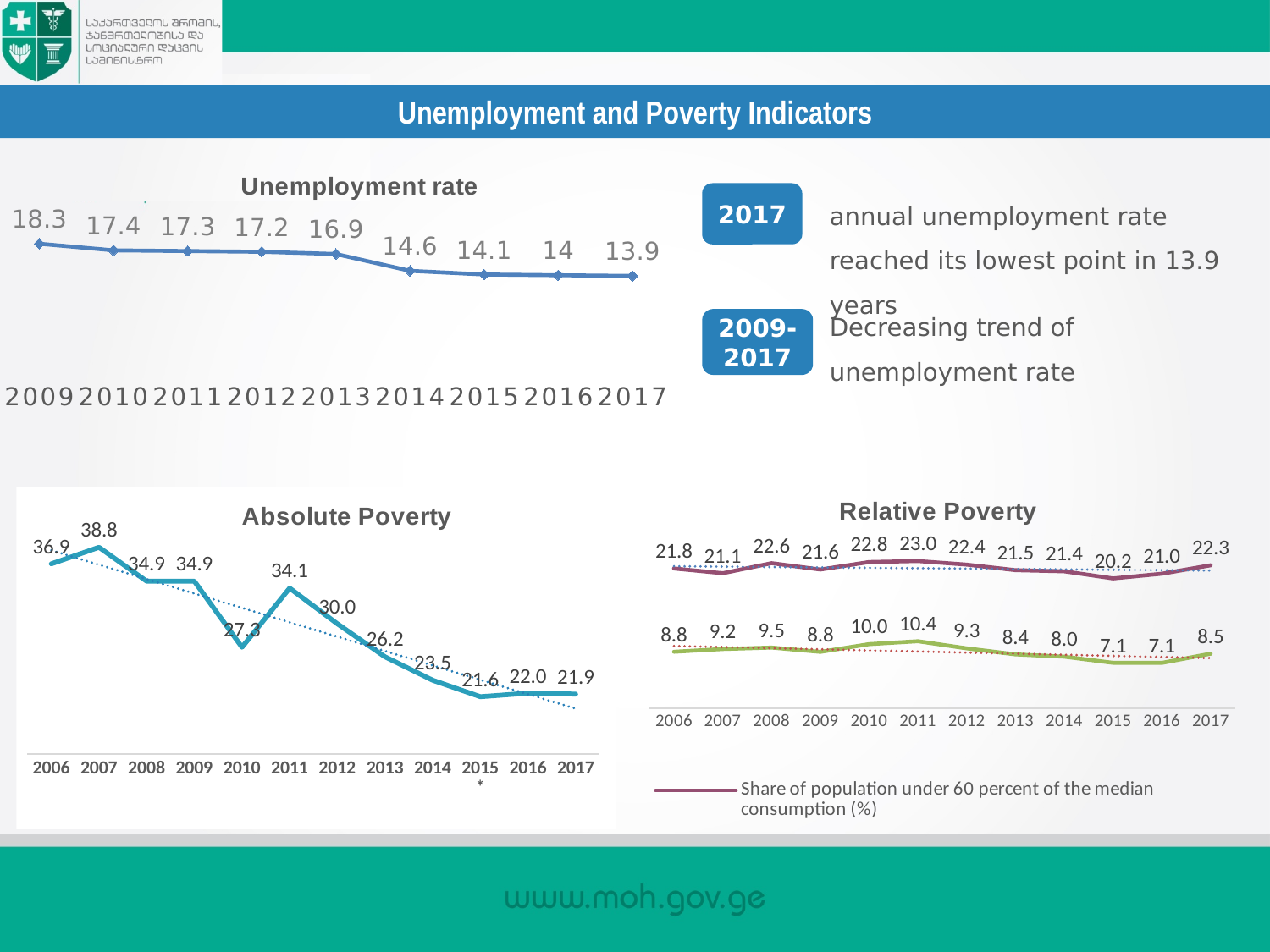
In the Unemployment rate chart, do the values rise or fall from 2009 to 2017? fall In the Unemployment rate chart, what is the difference between the 2009 and 2017 values? 4.4 In the Absolute Poverty chart, which year has the lowest value? 2015 What kind of chart is the Absolute Poverty chart? line chart In the Absolute Poverty chart, what is the value for 2011? 34.1 In the Absolute Poverty chart, which is larger, the value for 2010 or the value for 2012? 2012 In the Unemployment rate chart, what is the unemployment rate for 2013? 16.9 In the Relative Poverty chart, what is the value of the lower series for 2017? 8.5 In the Relative Poverty chart, what is the value of the share of population under 60 percent of the median consumption for 2011? 23.0 In the Unemployment rate chart, which year has the lowest unemployment rate? 2017 In the Unemployment rate chart, how many years are plotted? 9 In the Absolute Poverty chart, which year has the highest value? 2007